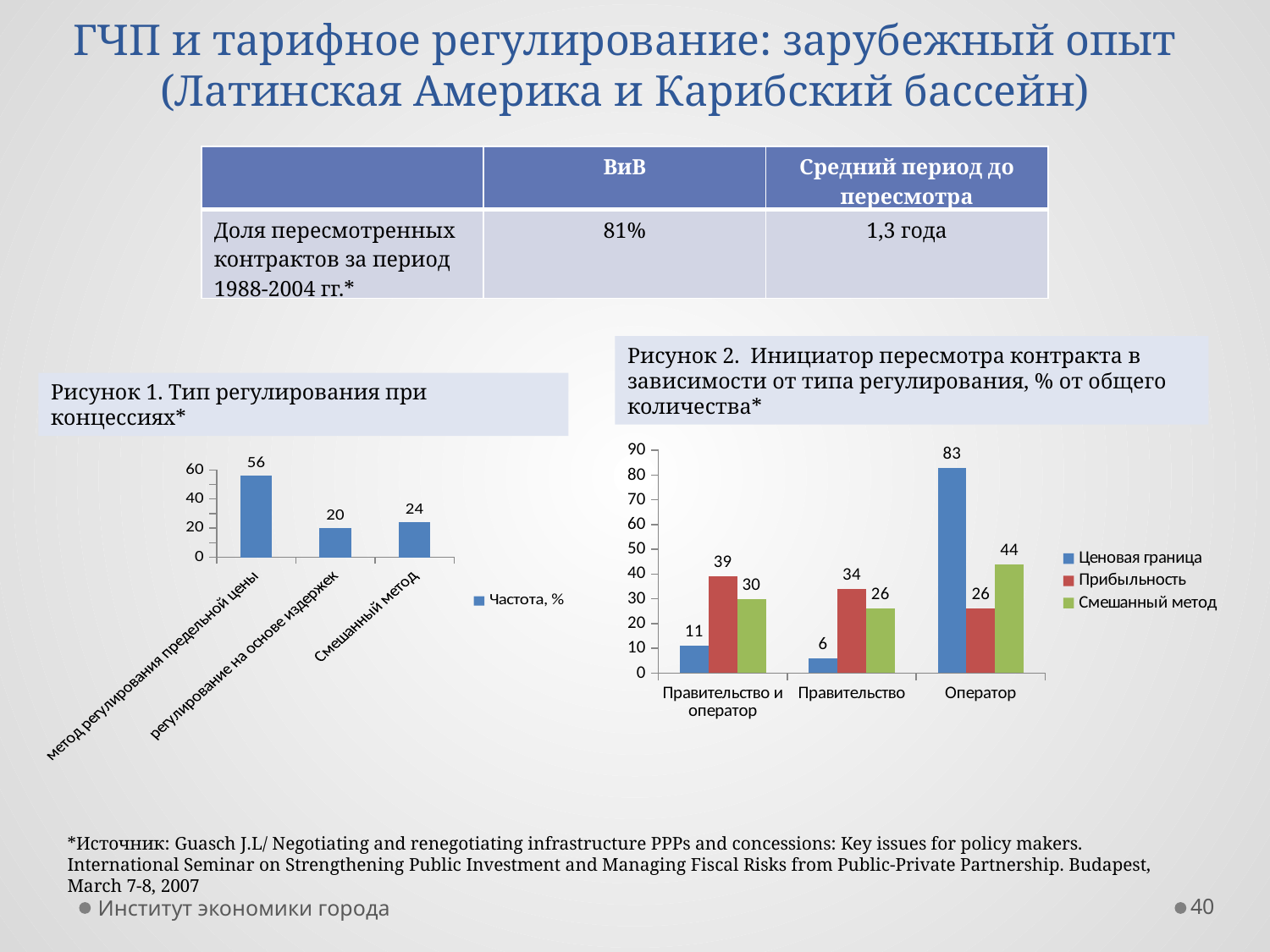
In the chart 'Рисунок 1. Тип регулирования при концессиях', which category has the highest value? метод регулирования предельной цены In the chart 'Рисунок 2', what is the value of 'Прибыльность' for 'Правительство и оператор'? 39 In the chart 'Рисунок 2', what is the difference between 'Смешанный метод' for 'Оператор' and 'Смешанный метод' for 'Правительство'? 18 In the chart 'Рисунок 2', how many series does the legend list? 3 In the chart 'Рисунок 1. Тип регулирования при концессиях', which category has the lowest value? регулирование на основе издержек In the chart 'Рисунок 1. Тип регулирования при концессиях', how many categories are shown? 3 In the chart 'Рисунок 1. Тип регулирования при концессиях', what is the difference between the values for 'метод регулирования предельной цены' and 'Смешанный метод'? 32 In the chart 'Рисунок 2', which is larger for 'Правительство': 'Прибыльность' or 'Смешанный метод'? Прибыльность In the chart 'Рисунок 2', what is the value of 'Ценовая граница' for 'Оператор'? 83 In the chart 'Рисунок 2', which category has the lowest value for 'Ценовая граница'? Правительство In the chart 'Рисунок 1. Тип регулирования при концессиях', what is the value for 'Смешанный метод'? 24 What type of chart is 'Рисунок 2'? Bar chart